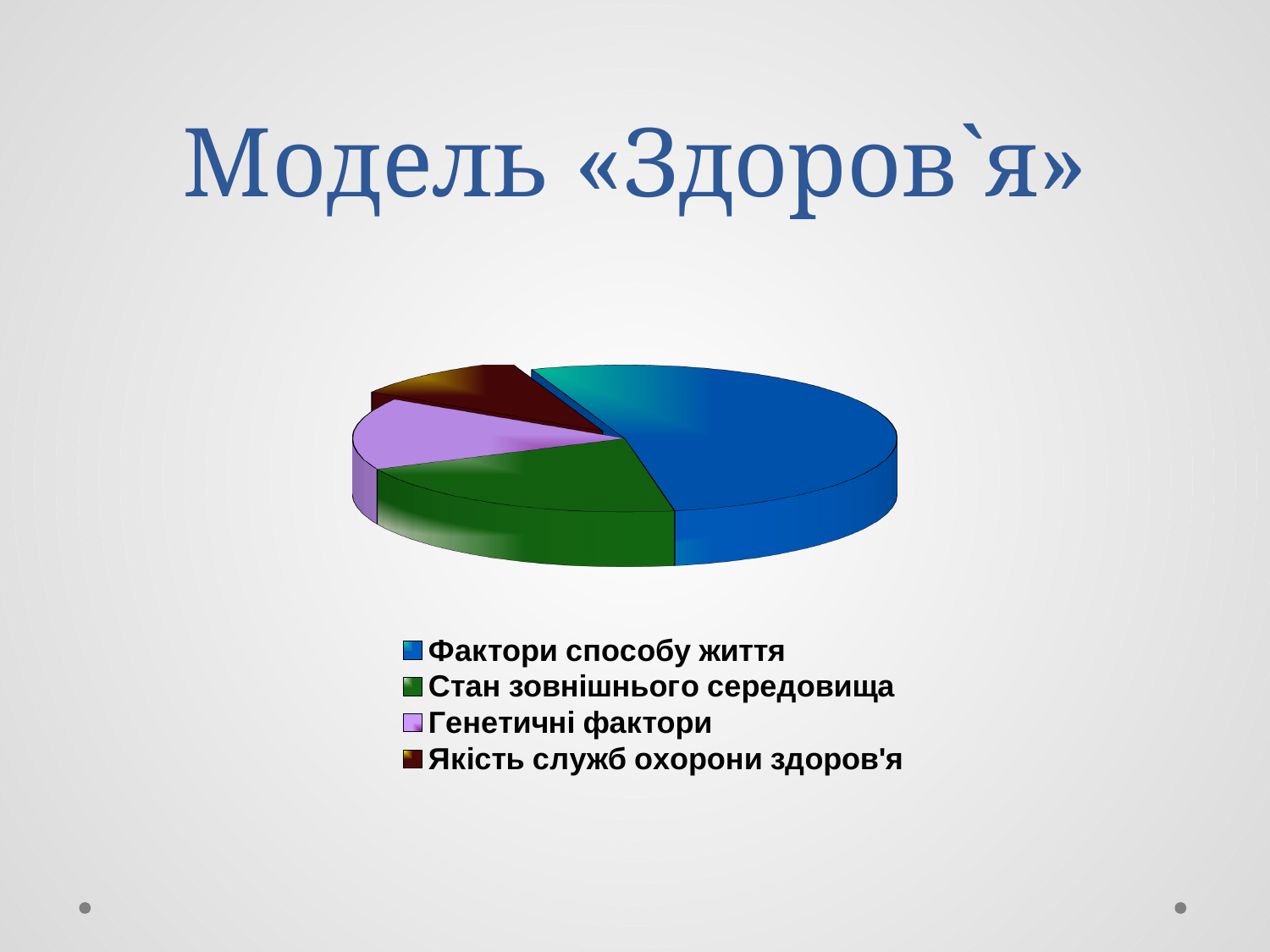
What is the title of the slide containing the pie chart? Модель «Здоров`я» Which category has the smallest slice of the pie? Якість служб охорони здоров'я Which slice is larger: Фактори способу життя or Стан зовнішнього середовища? Фактори способу життя What kind of chart is shown on the slide? pie chart Which slice is larger: Стан зовнішнього середовища or Якість служб охорони здоров'я? Стан зовнішнього середовища What colour is the slice for Генетичні фактори? purple Which slice is larger: Генетичні фактори or Якість служб охорони здоров'я? Генетичні фактори Which category has the largest slice of the pie? Фактори способу життя How many entries does the legend list? 4 How many slices does the pie chart have? 4